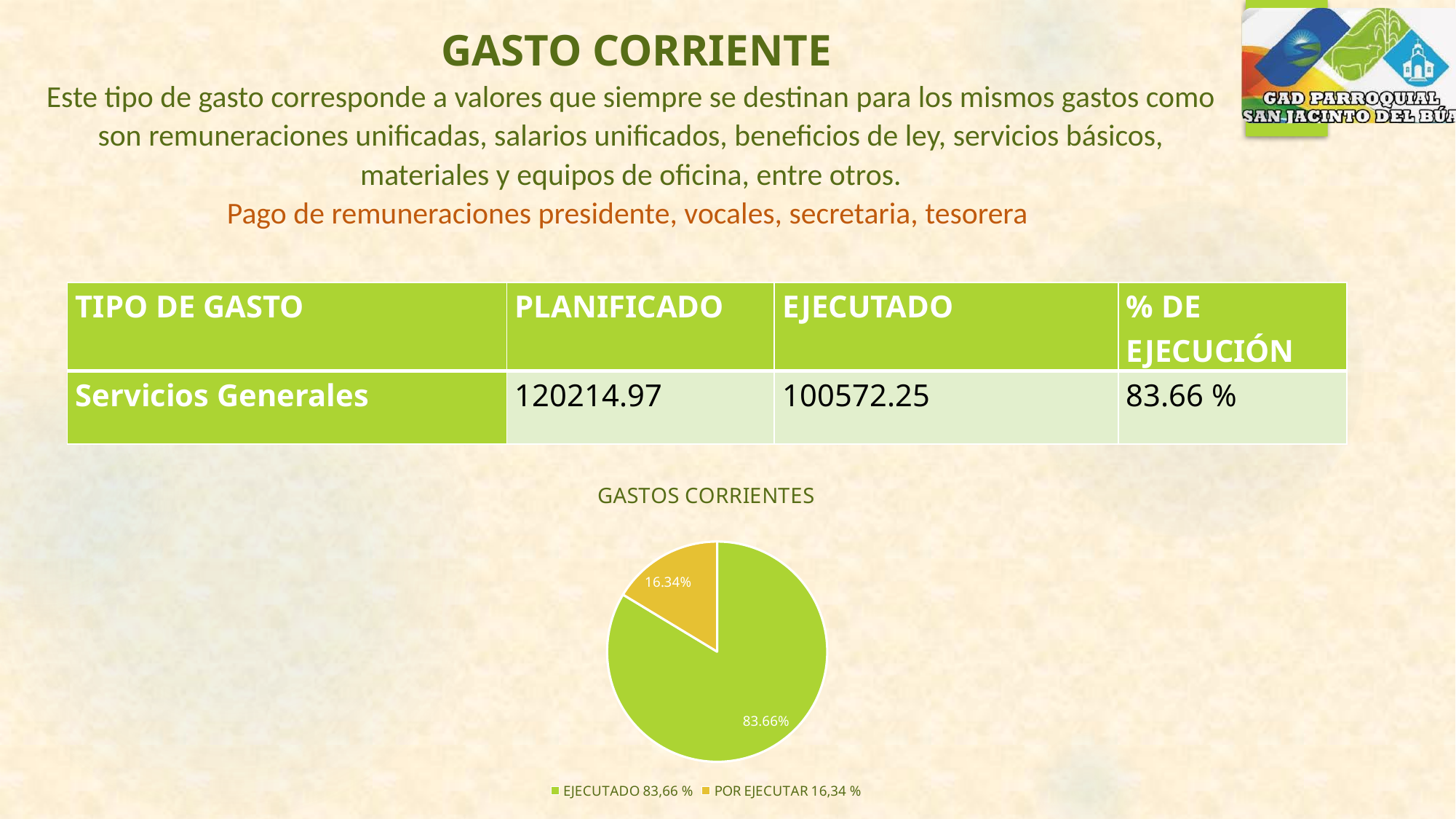
How many slices does the pie chart have? 2 How many entries does the chart legend list? 2 What is the title of the chart? GASTOS CORRIENTES Which slice of the pie chart is the smallest? POR EJECUTAR What percentage is shown for the POR EJECUTAR slice of the pie chart? 16.34% What percentage is shown for the EJECUTADO slice of the pie chart? 83.66% What is the difference in percentage points between the EJECUTADO and POR EJECUTAR slices? 67.32 What kind of chart is shown on the slide? pie chart Which is larger, the EJECUTADO slice or the POR EJECUTAR slice? EJECUTADO Is the EJECUTADO slice greater or less than 50% of the pie? greater Which slice of the pie chart is the largest? EJECUTADO What colour is the POR EJECUTAR slice in the pie chart? yellow